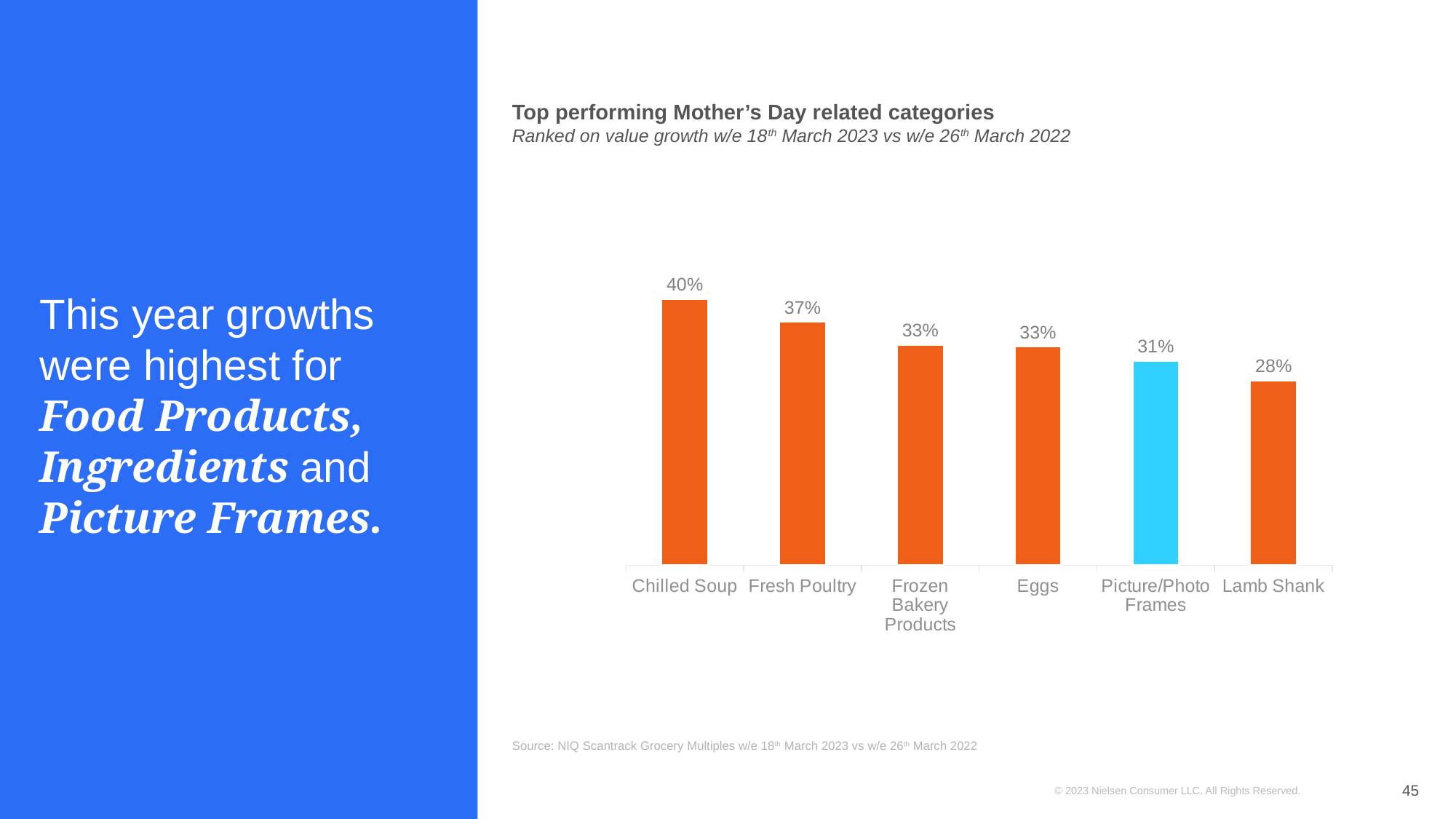
Which has higher value growth, Eggs or Lamb Shank? Eggs What is the value growth for Chilled Soup? 40% Which category has the lowest value growth? Lamb Shank What is the value growth for Lamb Shank? 28% What is the difference in value growth between Fresh Poultry and Picture/Photo Frames? 6% What is the value growth for Picture/Photo Frames? 31% How many categories are shown in the chart? 6 Which category's bar is coloured differently (light blue) from the others? Picture/Photo Frames What kind of chart is shown on the slide? Bar chart Which category has the highest value growth? Chilled Soup What is the difference in value growth between Chilled Soup and Lamb Shank? 12% What is the value growth for Fresh Poultry? 37%